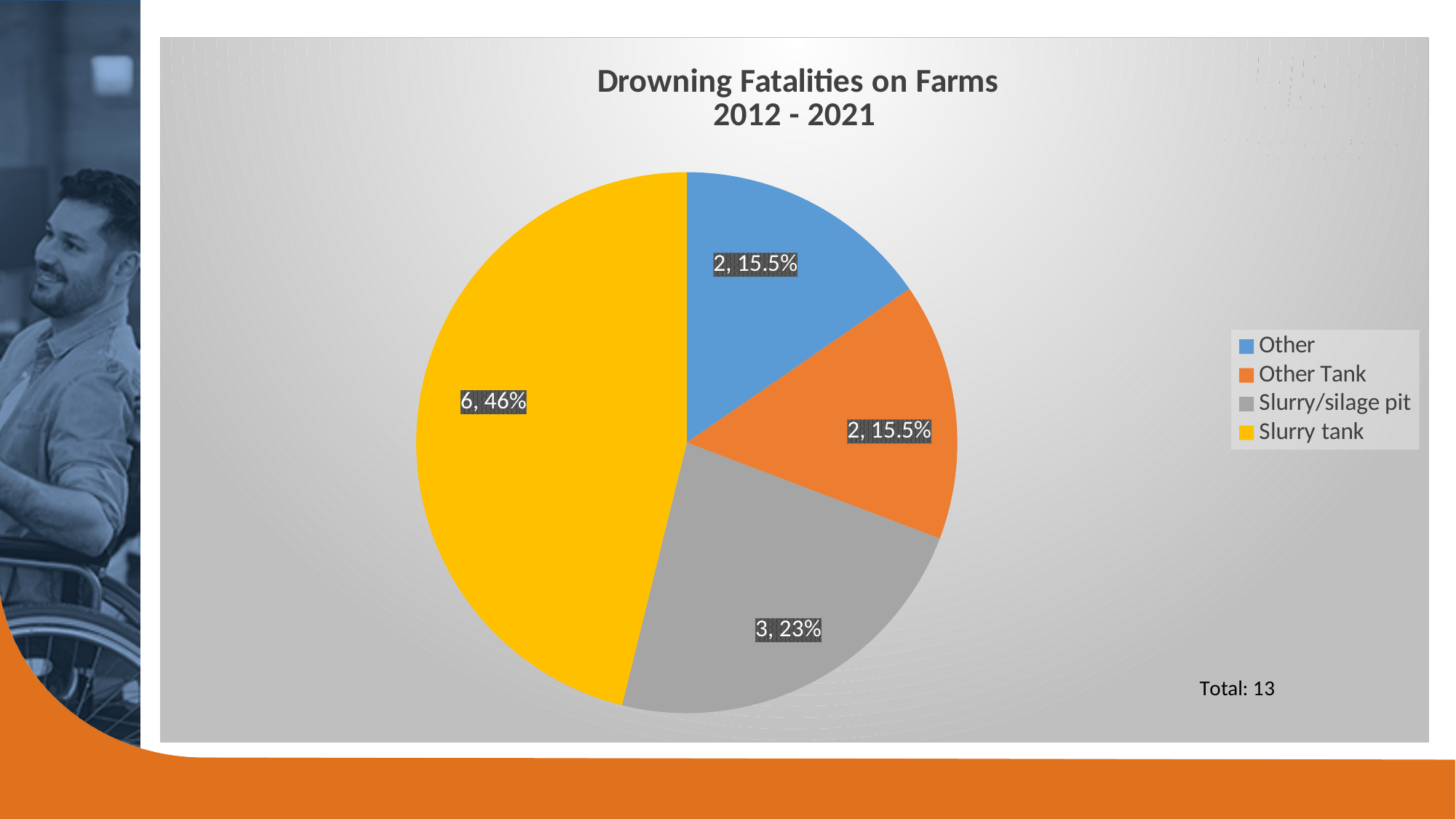
What is the difference in fatalities between Slurry tank and Slurry/silage pit? 3 Which is larger, the value for Slurry/silage pit or the value for Other Tank? Slurry/silage pit What share of the pie does Slurry tank represent? 46% How many drowning fatalities are attributed to Slurry tank? 6 What share of the pie does Slurry/silage pit represent? 23% How many categories does the pie chart have? 4 How many drowning fatalities are attributed to Slurry/silage pit? 3 What total number of fatalities is stated on the slide? 13 How many entries does the legend list? 4 What type of chart is shown on the slide? pie chart What is the title of the chart? Drowning Fatalities on Farms 2012 - 2021 Which category has the largest slice of the pie? Slurry tank